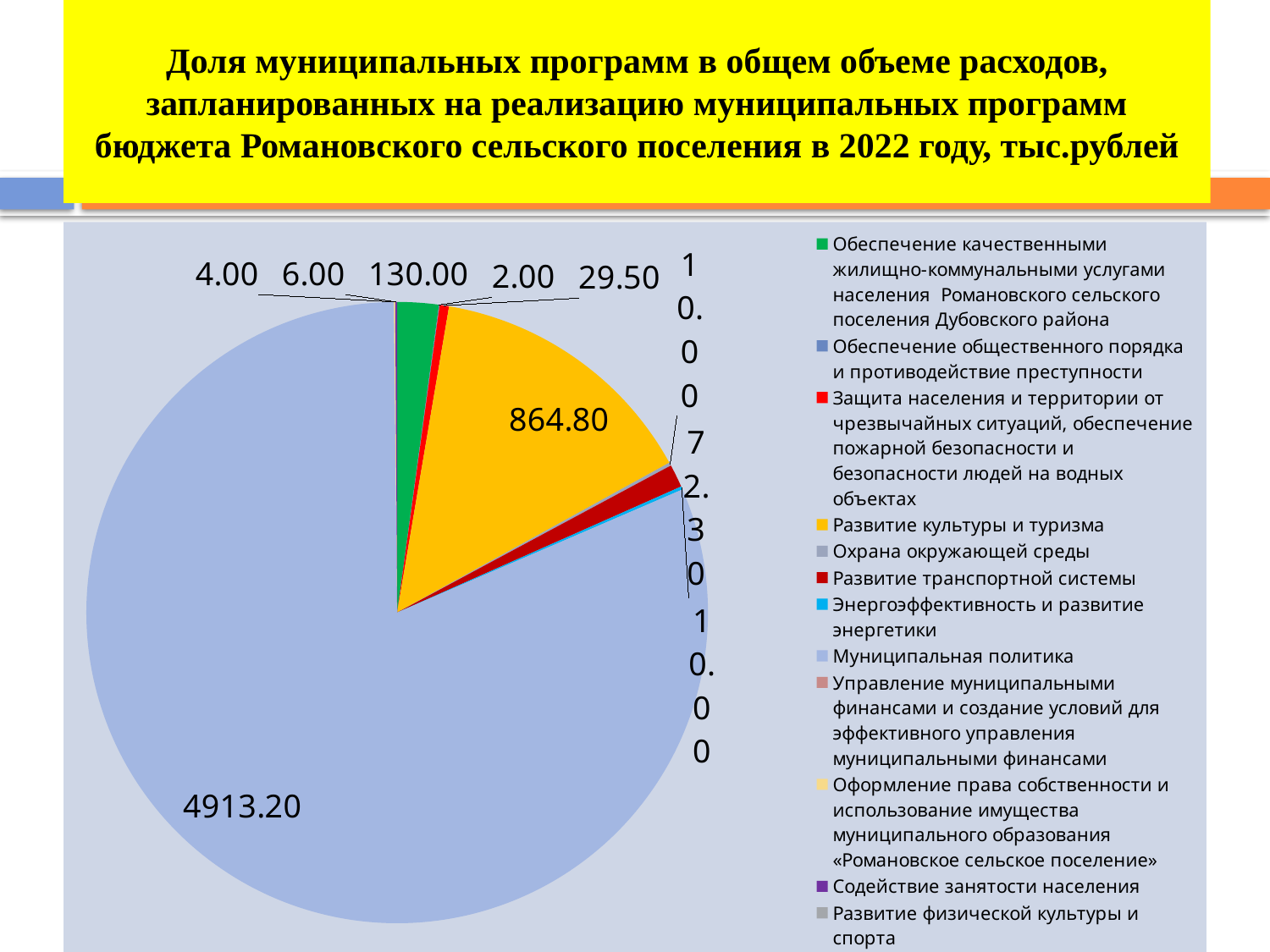
What is the value for Обеспечение качественными жилищно-коммунальными услугами населения Романовского сельского поселения Дубовского района? 130.00 What is the value shown for the largest slice of the pie? 4913.20 What is the difference between the values for Муниципальная политика and Развитие культуры и туризма? 4048.40 What is the value for Развитие культуры и туризма? 864.80 In what units are the values on the chart given, according to the title? тыс.рублей How many entries does the legend list? 12 Which is larger: the value for Развитие культуры и туризма or the value for Обеспечение качественными жилищно-коммунальными услугами? Развитие культуры и туризма Which is larger: the value for Муниципальная политика or the value for Развитие культуры и туризма? Муниципальная политика What is the difference between the values for Развитие культуры и туризма and Обеспечение качественными жилищно-коммунальными услугами? 734.80 What type of chart is shown on the slide? pie chart Which program has the largest slice of the pie? Муниципальная политика What colour is the slice for Развитие культуры и туризма? yellow